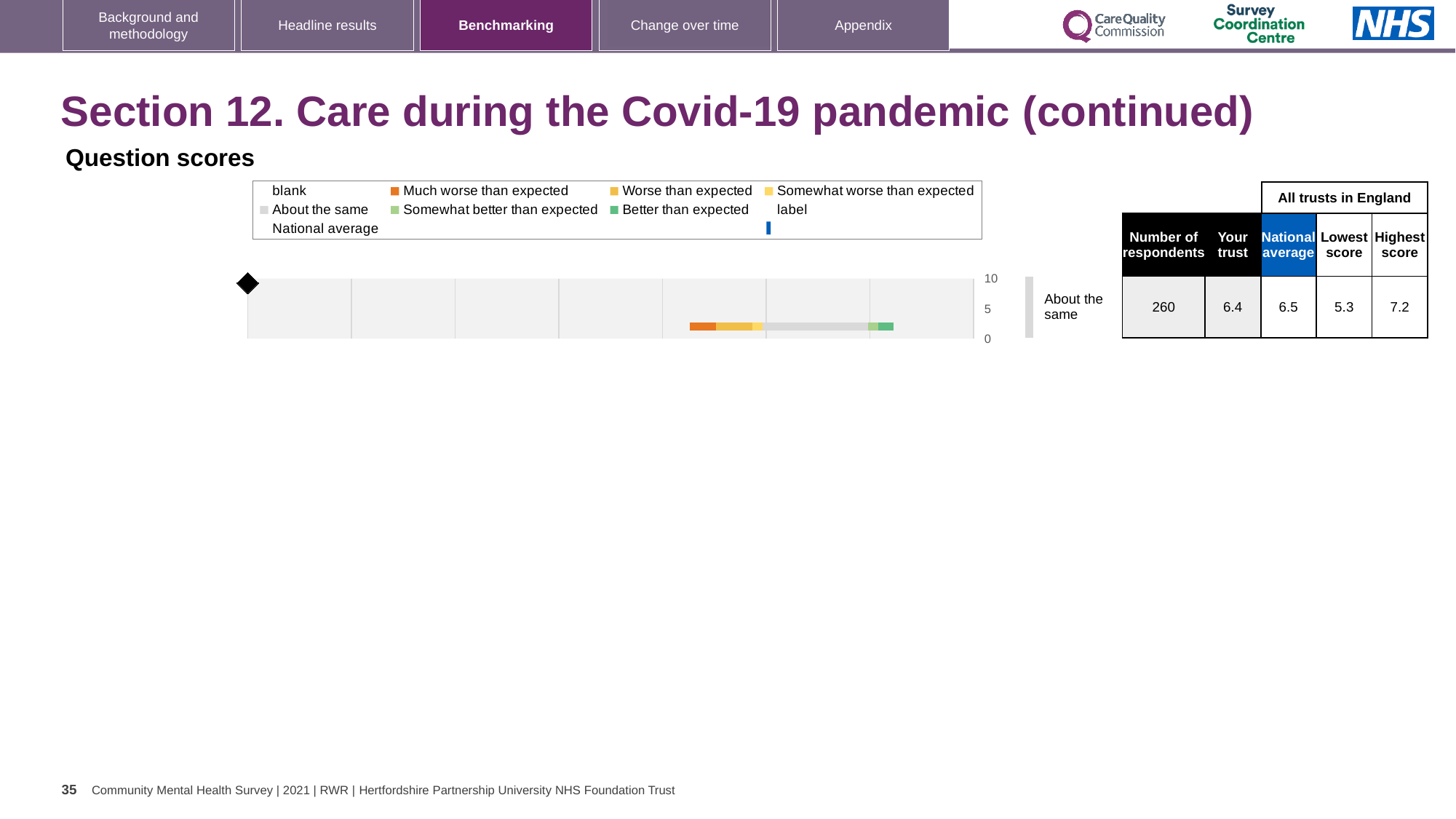
What is the national average score shown in the table? 6.5 How many respondents are shown in the table? 260 What is the lowest score among all trusts in England shown in the table? 5.3 Is the 'Your trust' score greater or less than 5 on the chart's axis? greater What is the maximum value shown on the chart's axis? 10 What is the 'Your trust' score shown in the table next to the chart? 6.4 Which is larger, the 'Your trust' score or the national average? National average What benchmark category label is shown beside the chart for this question? About the same What is the difference between the highest score and the lowest score in the table? 1.9 What is the highest score among all trusts in England shown in the table? 7.2 What kind of chart is shown under 'Question scores'? bar chart Which colour in the legend represents 'Much worse than expected'? Orange